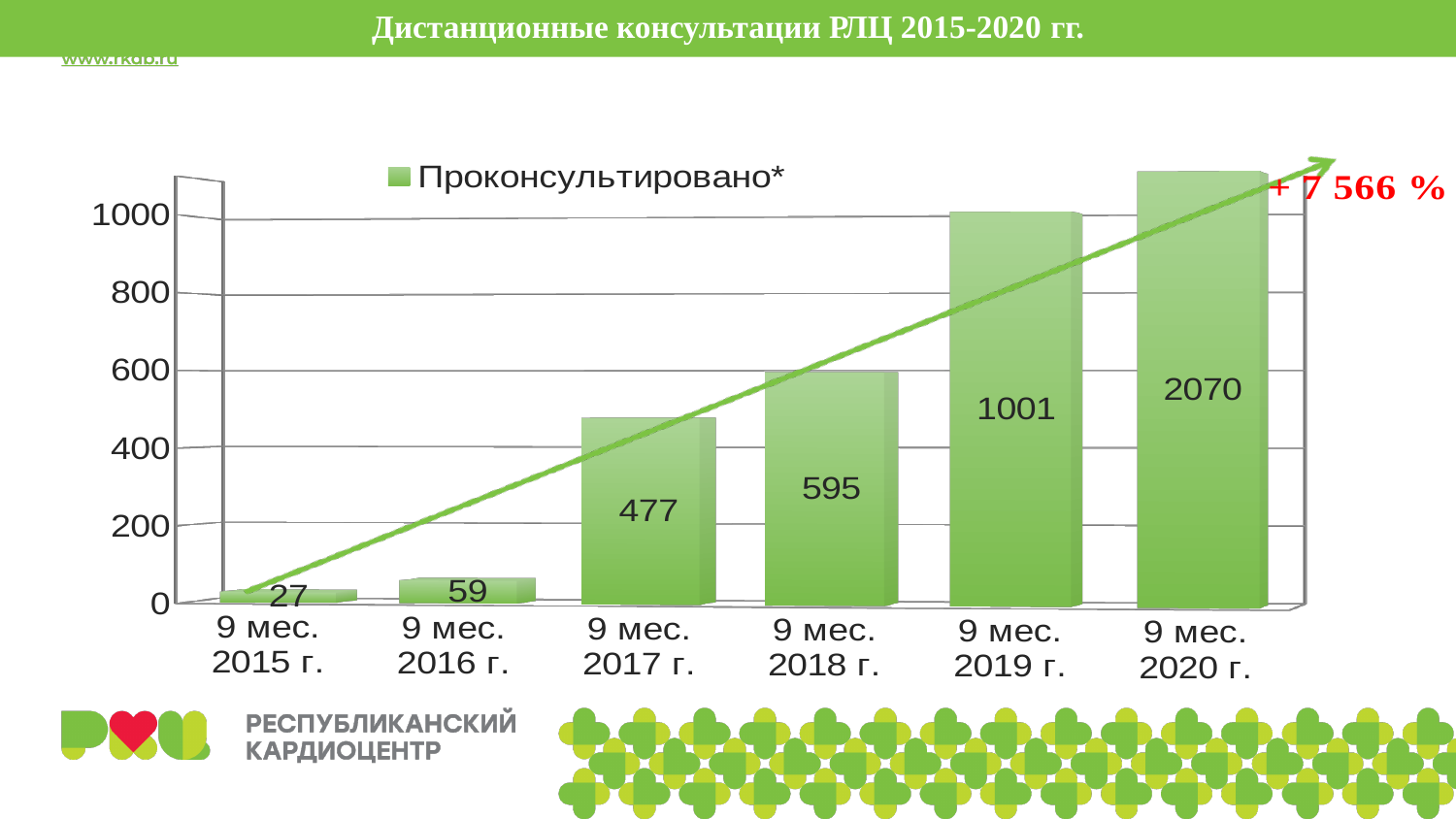
Do the values rise or fall from 2015 to 2020? rise What is the difference between the values for 9 мес. 2019 г. and 9 мес. 2018 г.? 406 What is the value for 9 мес. 2020 г.? 2070 What is the value for 9 мес. 2017 г.? 477 What is the value for 9 мес. 2015 г.? 27 What kind of chart is shown? bar chart Which category has the lowest value? 9 мес. 2015 г. Which is larger, the value for 9 мес. 2016 г. or 9 мес. 2017 г.? 9 мес. 2017 г. How many categories are shown on the x axis? 6 Is the value for 9 мес. 2019 г. greater or less than 800? greater Which category has the highest value? 9 мес. 2020 г. How many series does the legend list? 1